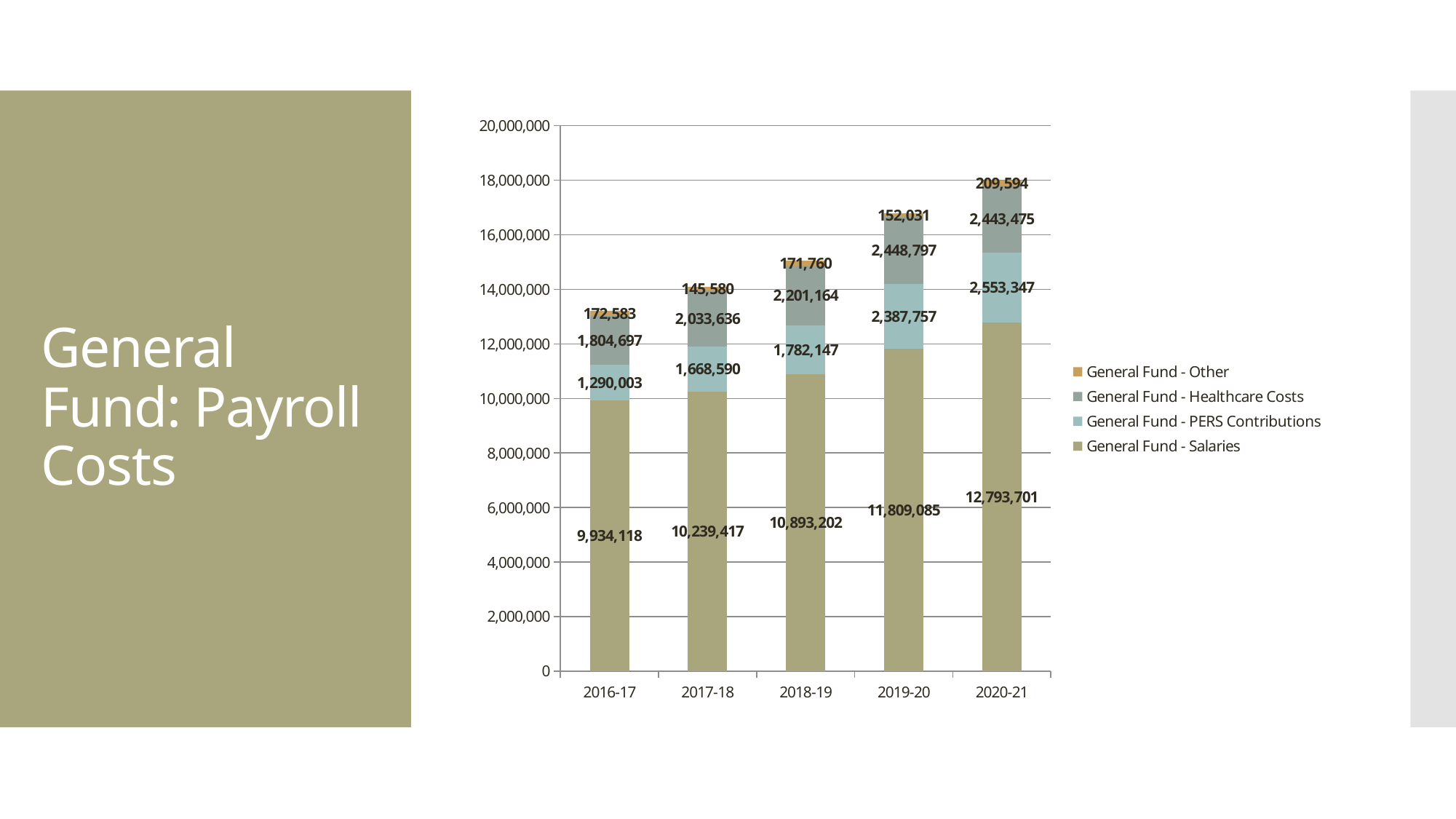
What is the value of General Fund - Other for 2019-20? 152,031 What is the difference between General Fund - Salaries in 2020-21 and in 2016-17? 2,859,583 Do the General Fund - Salaries values rise or fall from 2016-17 to 2020-21? rise Which year has the highest General Fund - Salaries value? 2020-21 What is the value of General Fund - PERS Contributions for 2017-18? 1,668,590 What is the value of General Fund - Salaries for 2018-19? 10,893,202 How many series does the legend list? 4 Which is larger: General Fund - Healthcare Costs in 2018-19 or General Fund - PERS Contributions in 2018-19? General Fund - Healthcare Costs What is the total of the stacked bar for 2016-17? 13,201,401 How many fiscal years are shown on the x axis? 5 What type of chart is shown on the slide? stacked bar chart Which year has the lowest General Fund - PERS Contributions value? 2016-17